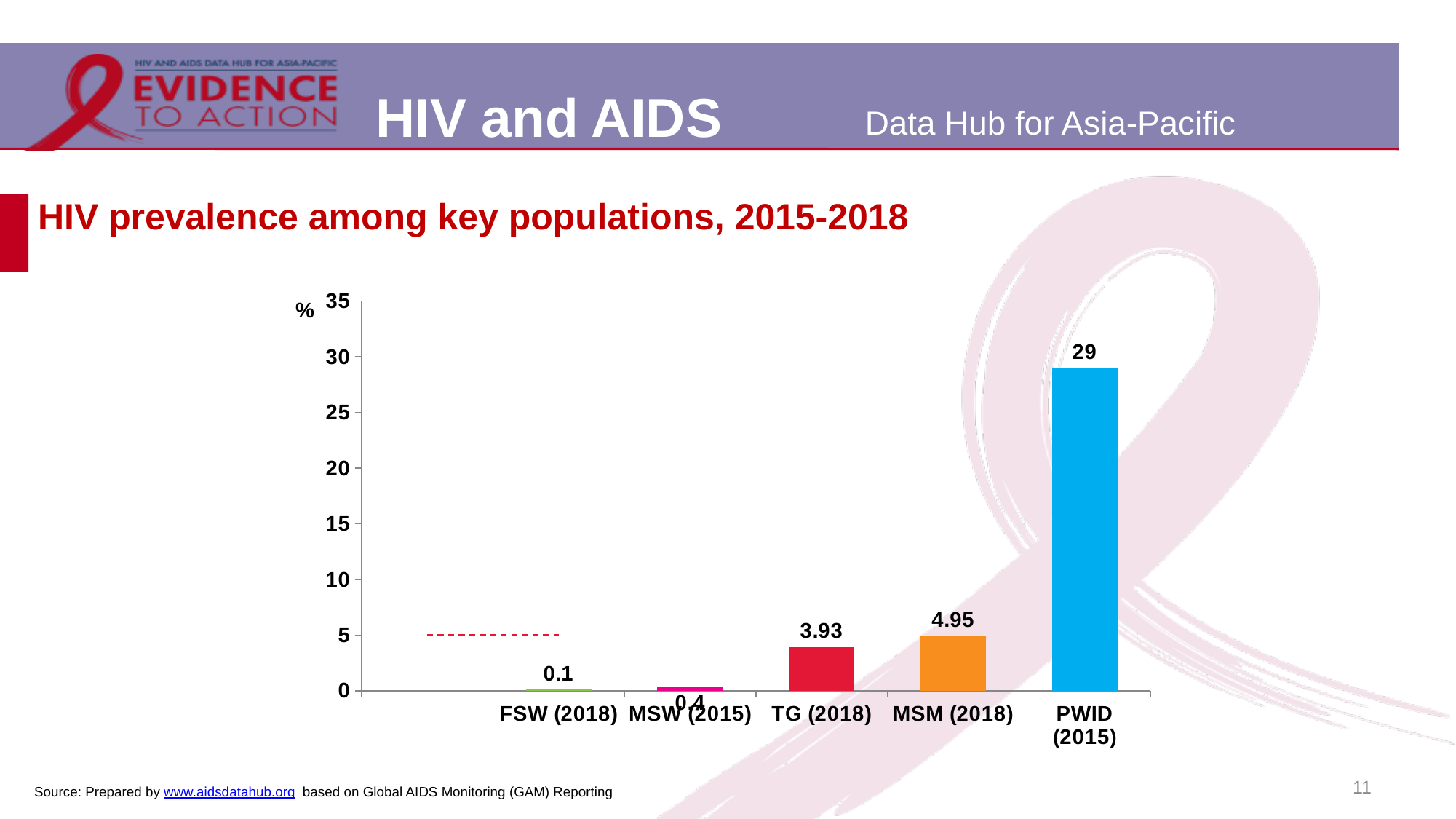
What is the HIV prevalence for TG (2018)? 3.93 What type of chart is used to show HIV prevalence among key populations? Bar chart What is the HIV prevalence for PWID (2015)? 29 What is the difference in HIV prevalence between MSM (2018) and TG (2018)? 1.02 Which key population has the lowest HIV prevalence? FSW (2018) Which has a higher HIV prevalence, TG (2018) or MSM (2018)? MSM (2018) What is the HIV prevalence for MSM (2018)? 4.95 What is the HIV prevalence for FSW (2018)? 0.1 Is the HIV prevalence for PWID (2015) greater or less than 25? greater Which key population has the highest HIV prevalence? PWID (2015) How many key population categories are shown in the chart? 5 What is the difference in HIV prevalence between PWID (2015) and MSM (2018)? 24.05